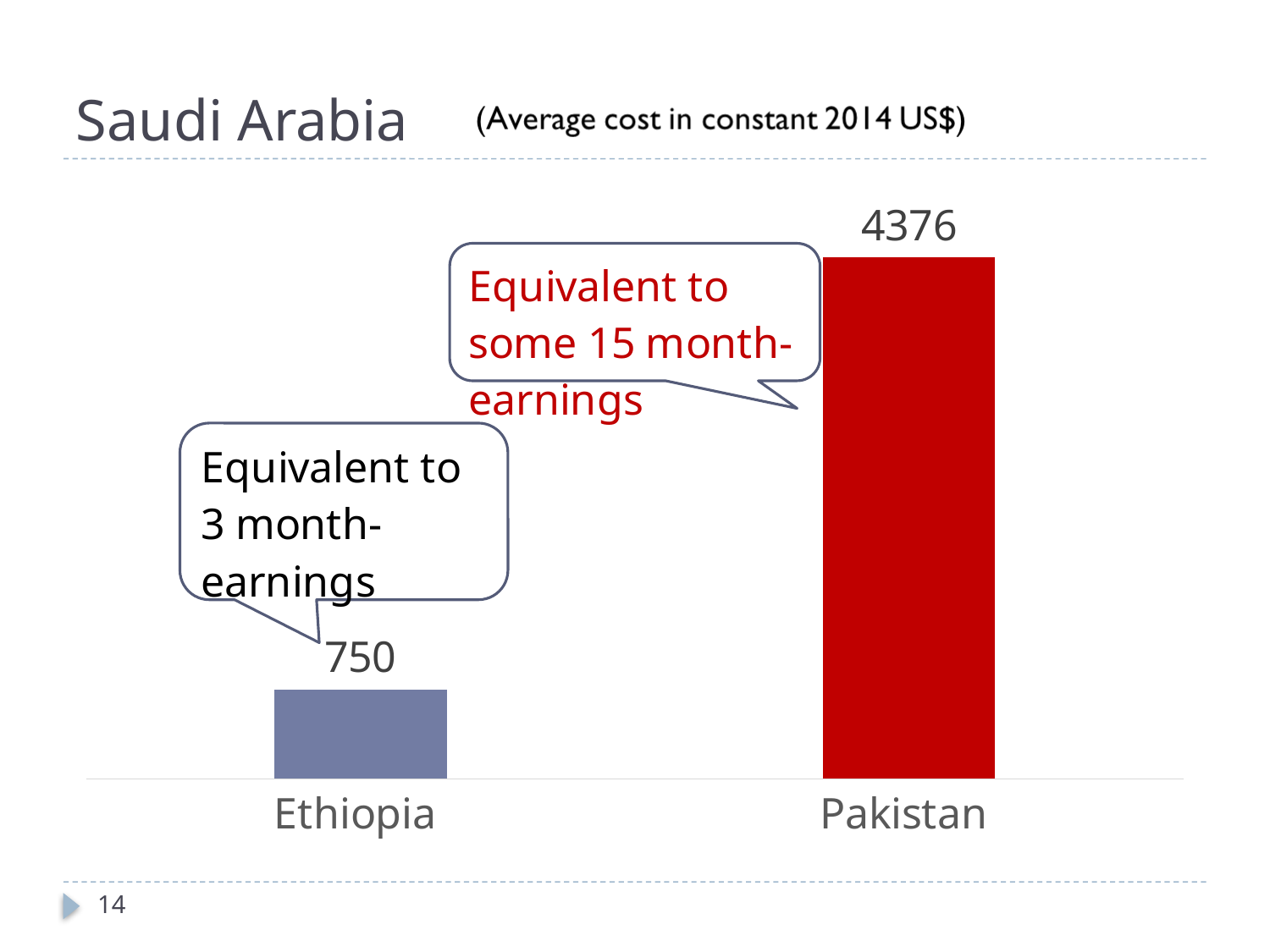
What is the value for Pakistan? 4376 Which is larger, the value for Ethiopia or the value for Pakistan? Pakistan What is the difference between the values for Pakistan and Ethiopia? 3626 How many categories are shown in the chart? 2 What kind of chart is shown on the slide? Bar chart According to the callout, how many months of earnings is the Ethiopia value equivalent to? 3 month-earnings Which category has the highest value? Pakistan What is the value for Ethiopia? 750 What unit does the subtitle say the costs are measured in? Constant 2014 US$ Which category has the lowest value? Ethiopia What is the total of the two values shown in the chart? 5126